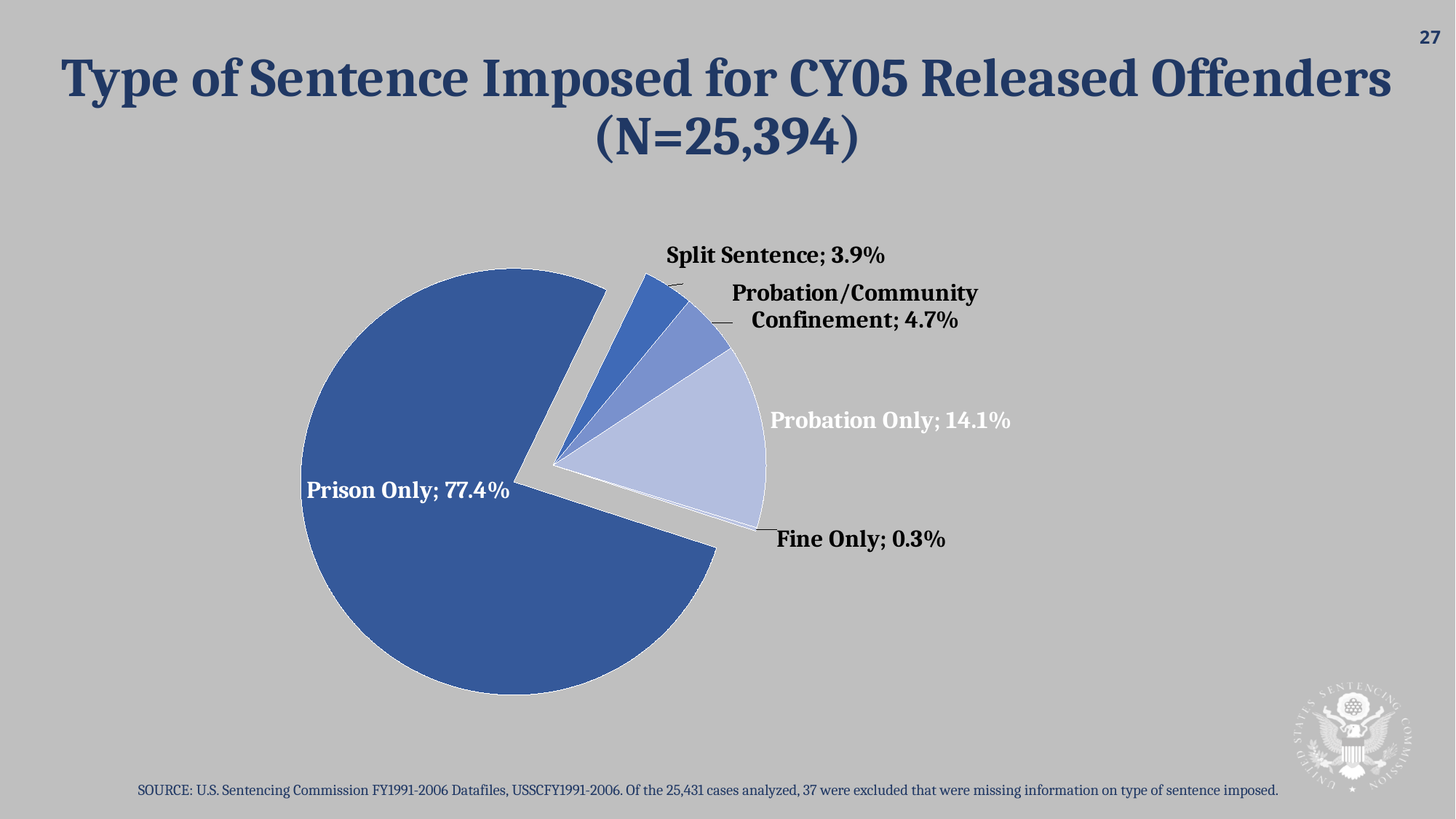
How many sentence types are shown in the pie chart? 5 Which type of sentence has the smallest slice of the pie? Fine Only What is the value for Fine Only? 0.3% What kind of chart is shown on the slide? Pie chart What percentage of CY05 released offenders received a Prison Only sentence? 77.4% What is the difference in percentage points between Prison Only and Probation Only? 63.3 Which type of sentence has the largest slice of the pie? Prison Only Which is larger, Probation/Community Confinement or Split Sentence? Probation/Community Confinement What share of the pie is Probation Only? 14.1% What is the value shown for Split Sentence? 3.9% What percentage is shown for Probation/Community Confinement? 4.7% What is the N value given in the chart title? 25,394